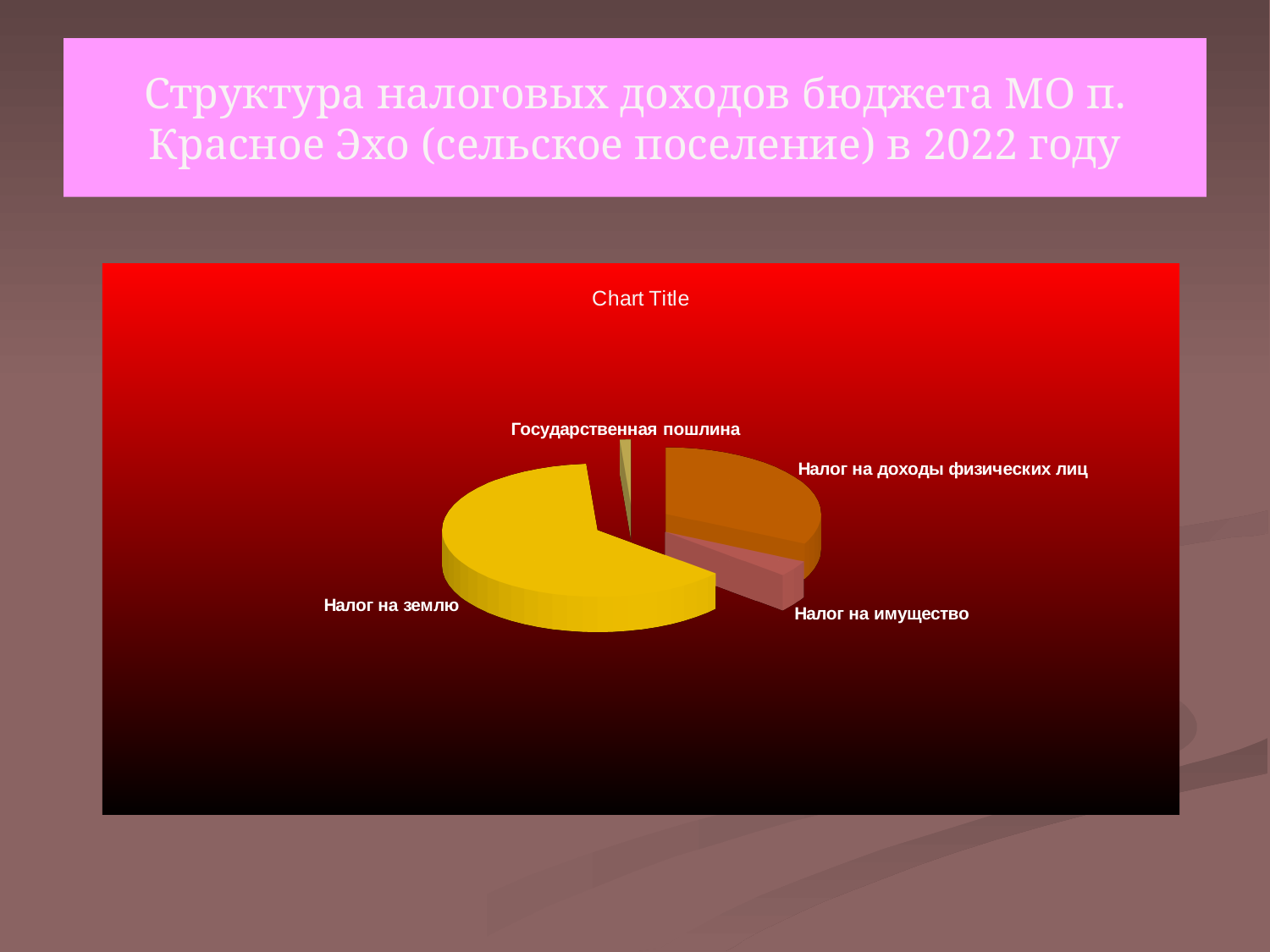
Which slice is larger: Налог на имущество or Государственная пошлина? Налог на имущество Which category has the largest slice of the pie? Налог на землю Which slice is larger: Налог на землю or Налог на доходы физических лиц? Налог на землю Which slice is larger: Налог на землю or Налог на имущество? Налог на землю What title is printed above the pie chart? Chart Title How many slices does the pie chart have? 4 Which category has the smallest slice of the pie? Государственная пошлина What colour is the slice for Налог на землю? yellow What kind of chart is shown on the slide? pie chart